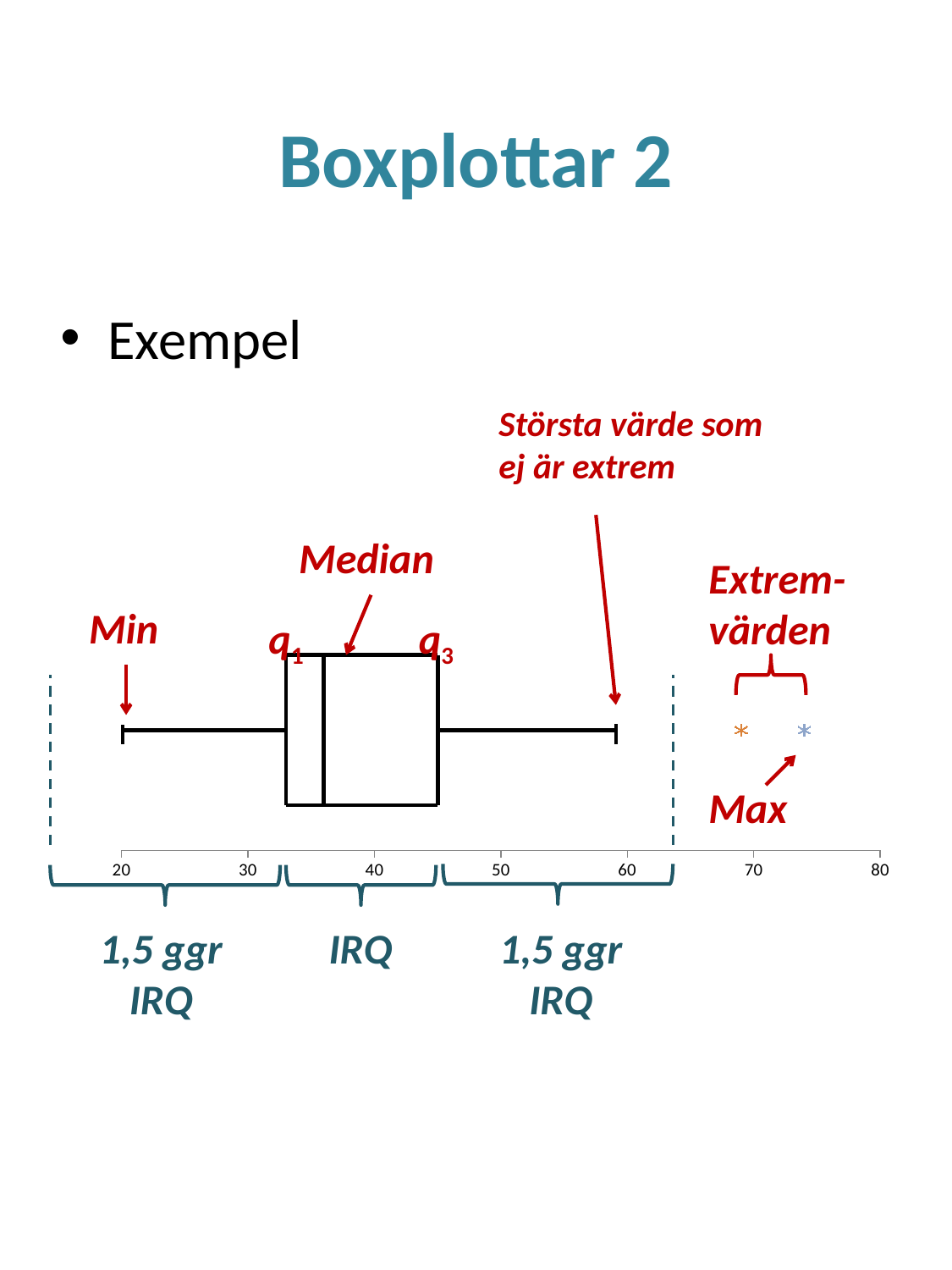
What is the lowest value shown on the horizontal axis of the box plot? 20 Is q3 of the box plot greater or less than 50? less Is the median of the box plot greater or less than 40? less Is the largest non-extreme value (end of the right whisker) greater or less than 50? greater Which is larger in the box plot, the median or q3? q3 What is the title of the slide containing the box plot? Boxplottar 2 How many extreme values (Extremvärden) are plotted as asterisks in the box plot? 2 What kind of chart is shown on the slide? Box plot What is the highest value shown on the horizontal axis of the box plot? 80